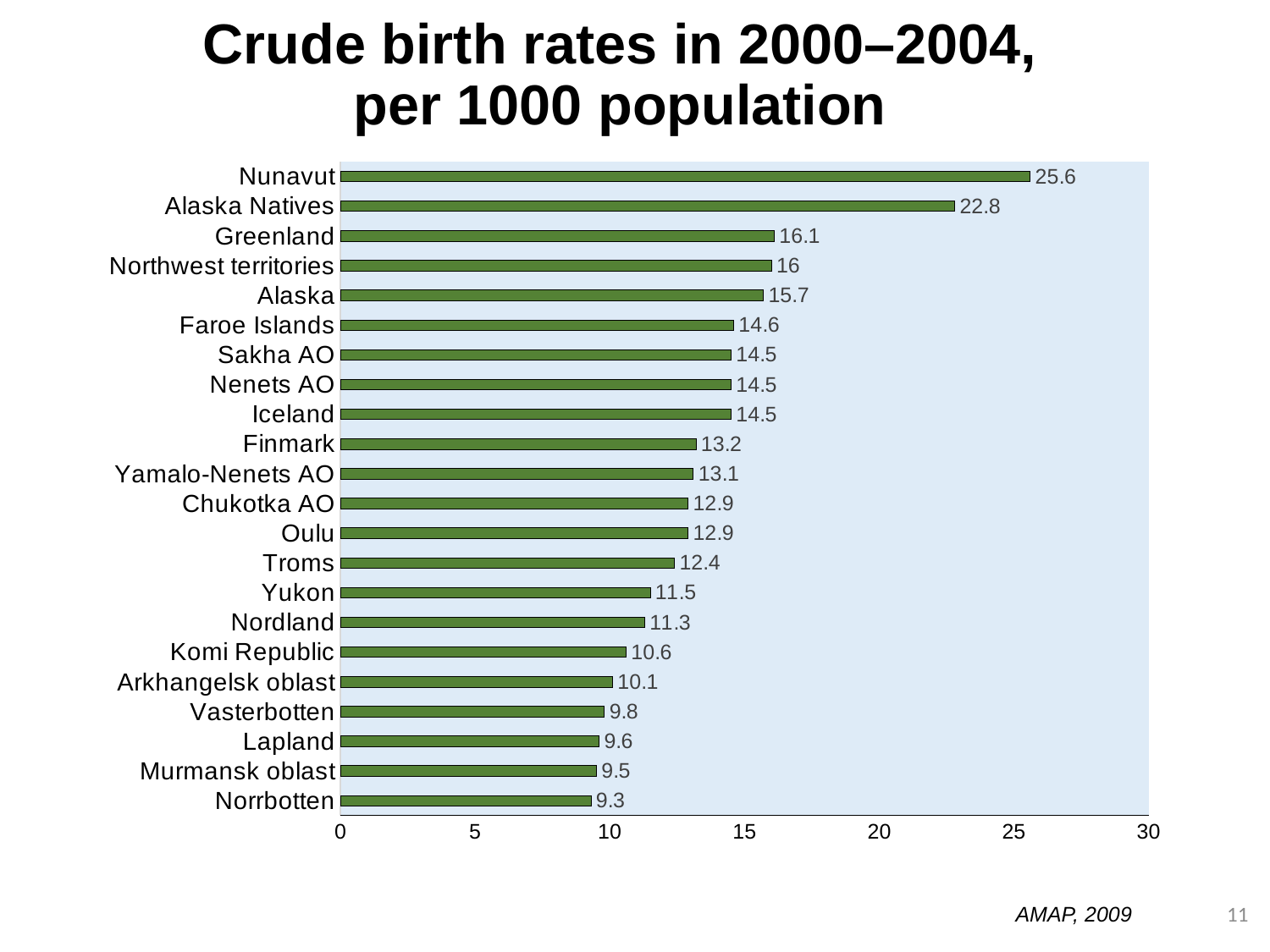
What is the maximum value shown on the horizontal axis? 30 Which has a higher crude birth rate, Yukon or Troms? Troms How many regions are shown in the chart? 22 What is the difference between the crude birth rates of Finmark and Lapland? 3.6 Which region has the highest crude birth rate? Nunavut Which region has the lowest crude birth rate? Norrbotten What kind of chart is shown on the slide? bar chart What is the crude birth rate for Greenland? 16.1 What is the difference between the crude birth rates of Nunavut and Alaska Natives? 2.8 What is the crude birth rate for Komi Republic? 10.6 What is the crude birth rate for Murmansk oblast? 9.5 Is the value for Alaska greater or less than 15? greater